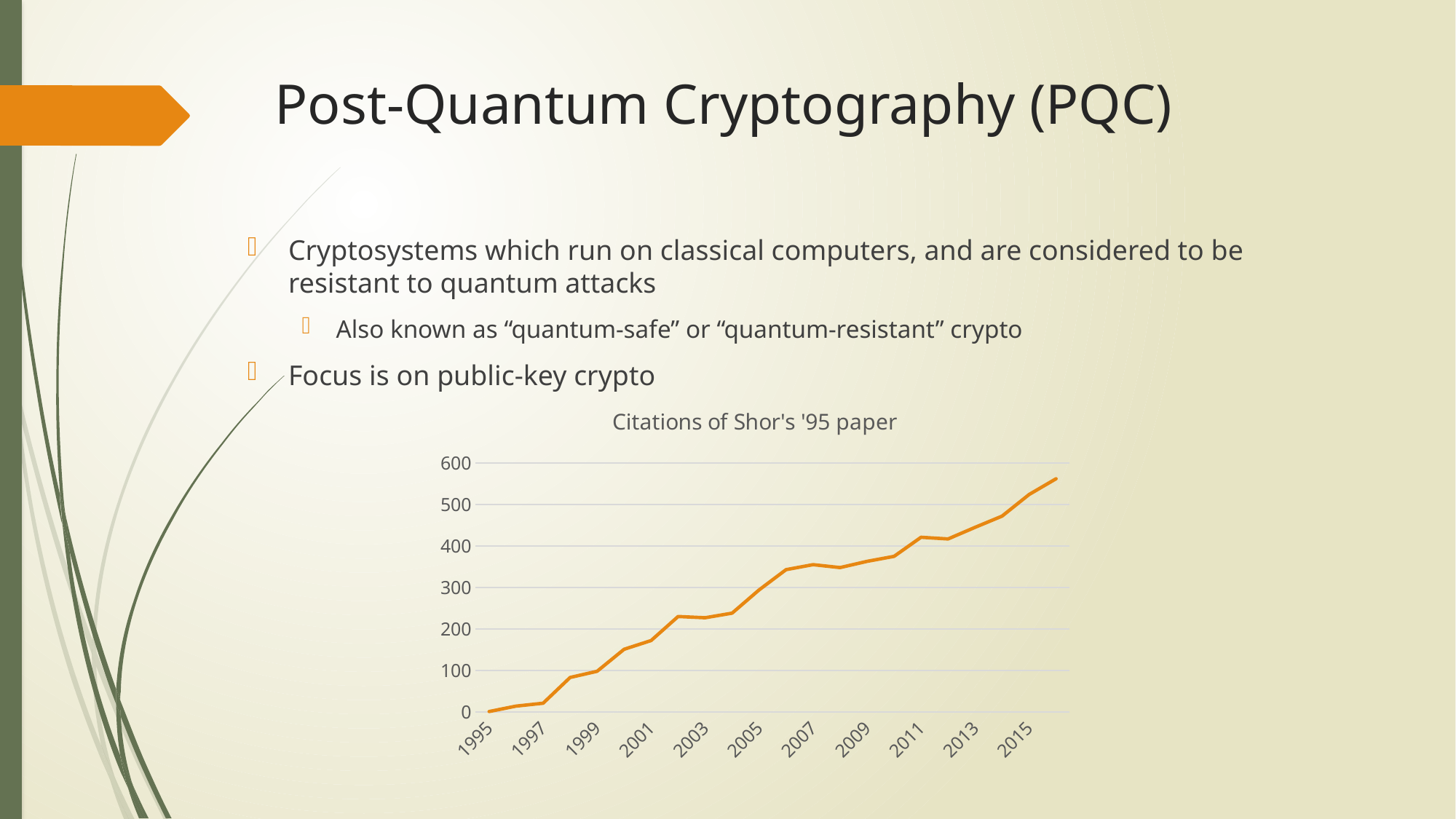
Is the value for 2011 greater or less than 400? greater Is the value for 1997 greater or less than 100? less Is the value for 2001 greater or less than 200? less Do the citation values generally rise or fall from 1995 to the right end of the x axis? rise Which of the labeled years on the x axis has the lowest value? 1995 What kind of chart is shown on the slide? line chart Which of the labeled years on the x axis has the highest value? 2015 What is the title of the chart? Citations of Shor's '95 paper Which year has the larger value, 2007 or 2011? 2011